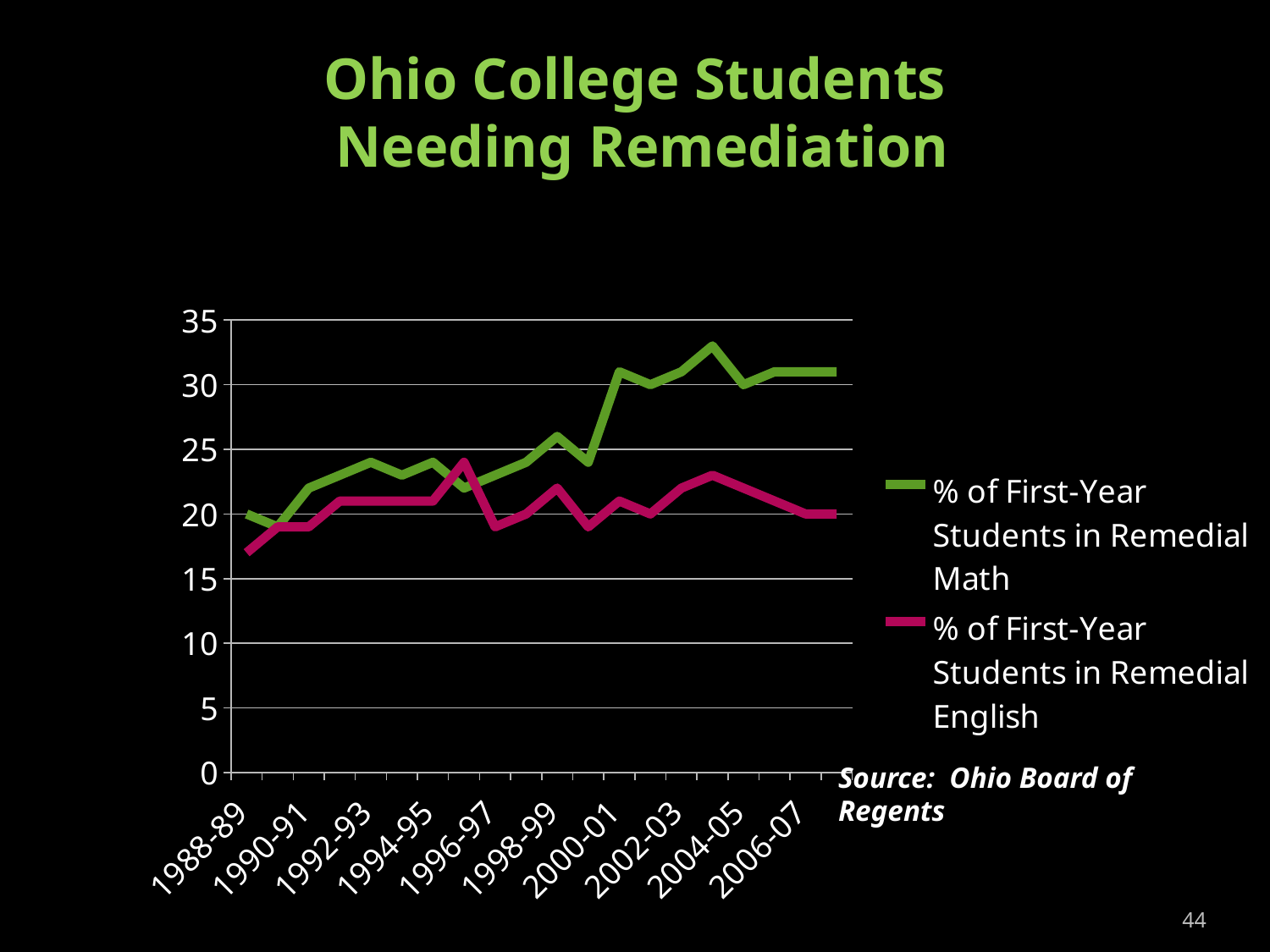
Is the value for % of First-Year Students in Remedial Math in 1996-97 greater or less than 25? less Does the % of First-Year Students in Remedial Math generally rise or fall from 1988-89 to 2006-07? rise Is the value for % of First-Year Students in Remedial Math in 2006-07 greater or less than 30? greater Is the value for % of First-Year Students in Remedial English in 1988-89 greater or less than 20? less In 2004-05, which series has the higher value: Remedial Math or Remedial English? % of First-Year Students in Remedial Math What kind of chart is shown on the slide? Line chart In which year does the % of First-Year Students in Remedial Math reach its highest value? 2003-04 What is the title of the chart? Ohio College Students Needing Remediation How many series does the legend list? 2 Which colour is used for the % of First-Year Students in Remedial English line? Pink (magenta)